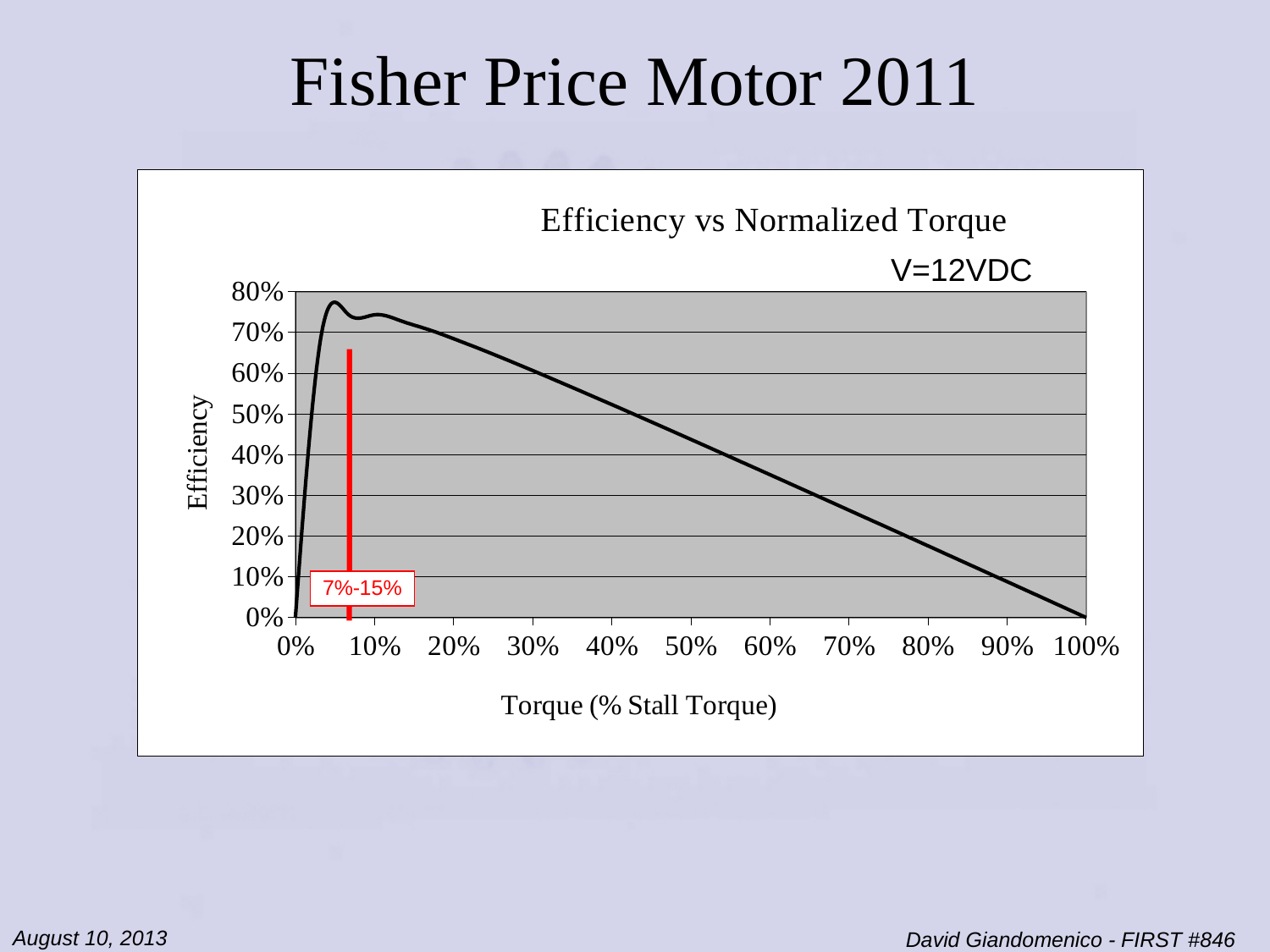
Is the peak efficiency on the curve greater or less than 80%? less How many tick labels are shown on the x axis? 11 What voltage is noted on the chart? V=12VDC Is the efficiency at 10% stall torque greater or less than 70%? greater What kind of chart is shown on the slide? line chart Is the efficiency at 60% stall torque greater or less than 40%? less Does efficiency rise or fall as torque increases from 20% to 100% of stall torque? fall What is the efficiency at 0% stall torque? 0% What is the title of the chart? Efficiency vs Normalized Torque What is the efficiency at 100% stall torque? 0%